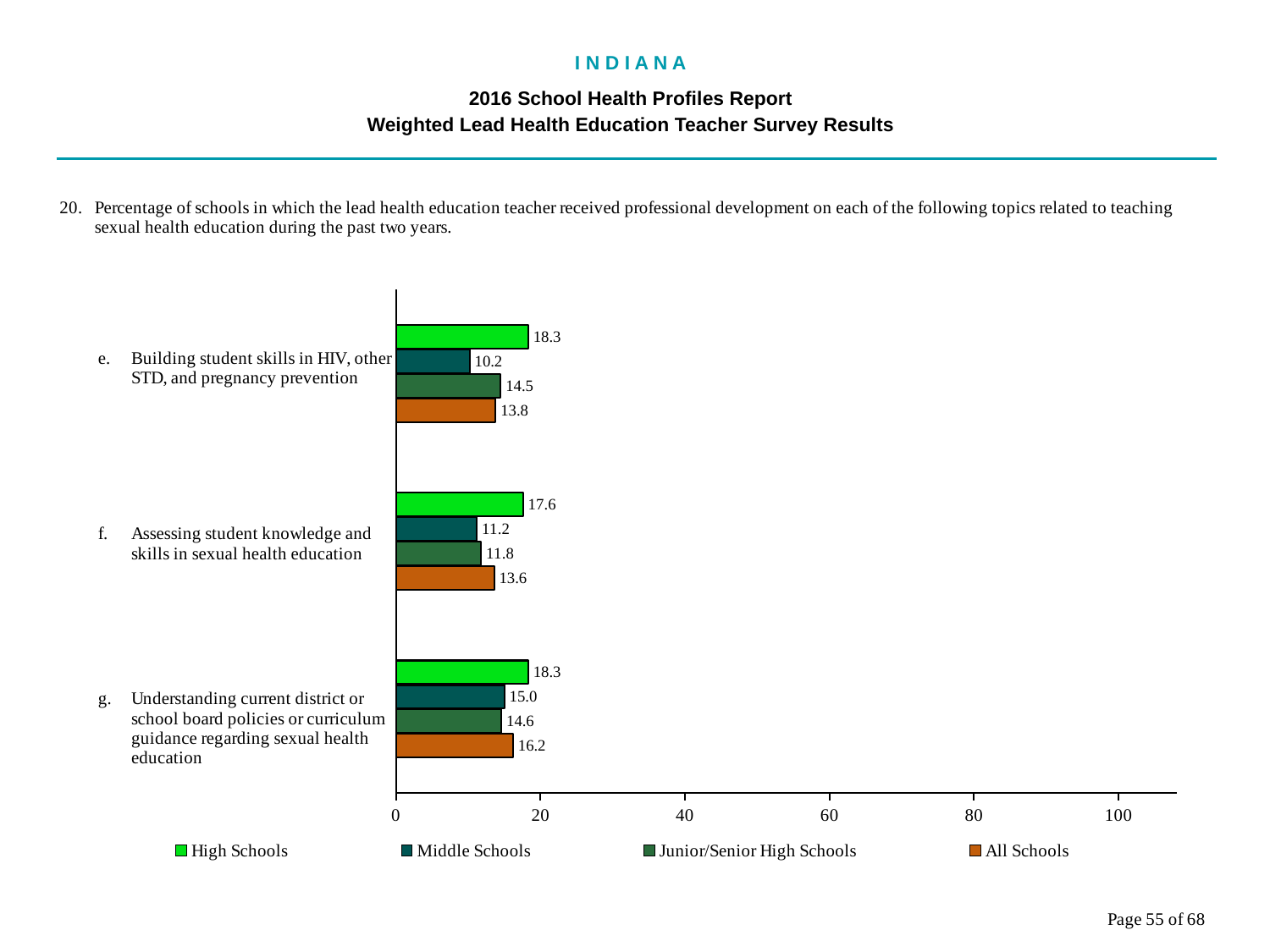
Which is larger for 'Assessing student knowledge and skills in sexual health education': the All Schools value or the Junior/Senior High Schools value? All Schools What is the value for Junior/Senior High Schools for 'Assessing student knowledge and skills in sexual health education'? 11.8 What kind of chart is shown on the slide? Bar chart What is the value for All Schools for 'Understanding current district or school board policies or curriculum guidance regarding sexual health education'? 16.2 What is the difference between the High Schools and Middle Schools values for 'Building student skills in HIV, other STD, and pregnancy prevention'? 8.1 How many series does the legend list? 4 How many topic categories are shown on the chart? 3 What is the value for Middle Schools for 'Assessing student knowledge and skills in sexual health education'? 11.2 What is the value for High Schools for 'Building student skills in HIV, other STD, and pregnancy prevention'? 18.3 Is the value for High Schools for 'Assessing student knowledge and skills in sexual health education' greater or less than 20? less Which school type has the lowest value for 'Building student skills in HIV, other STD, and pregnancy prevention'? Middle Schools Which school type has the highest value for 'Understanding current district or school board policies or curriculum guidance regarding sexual health education'? High Schools